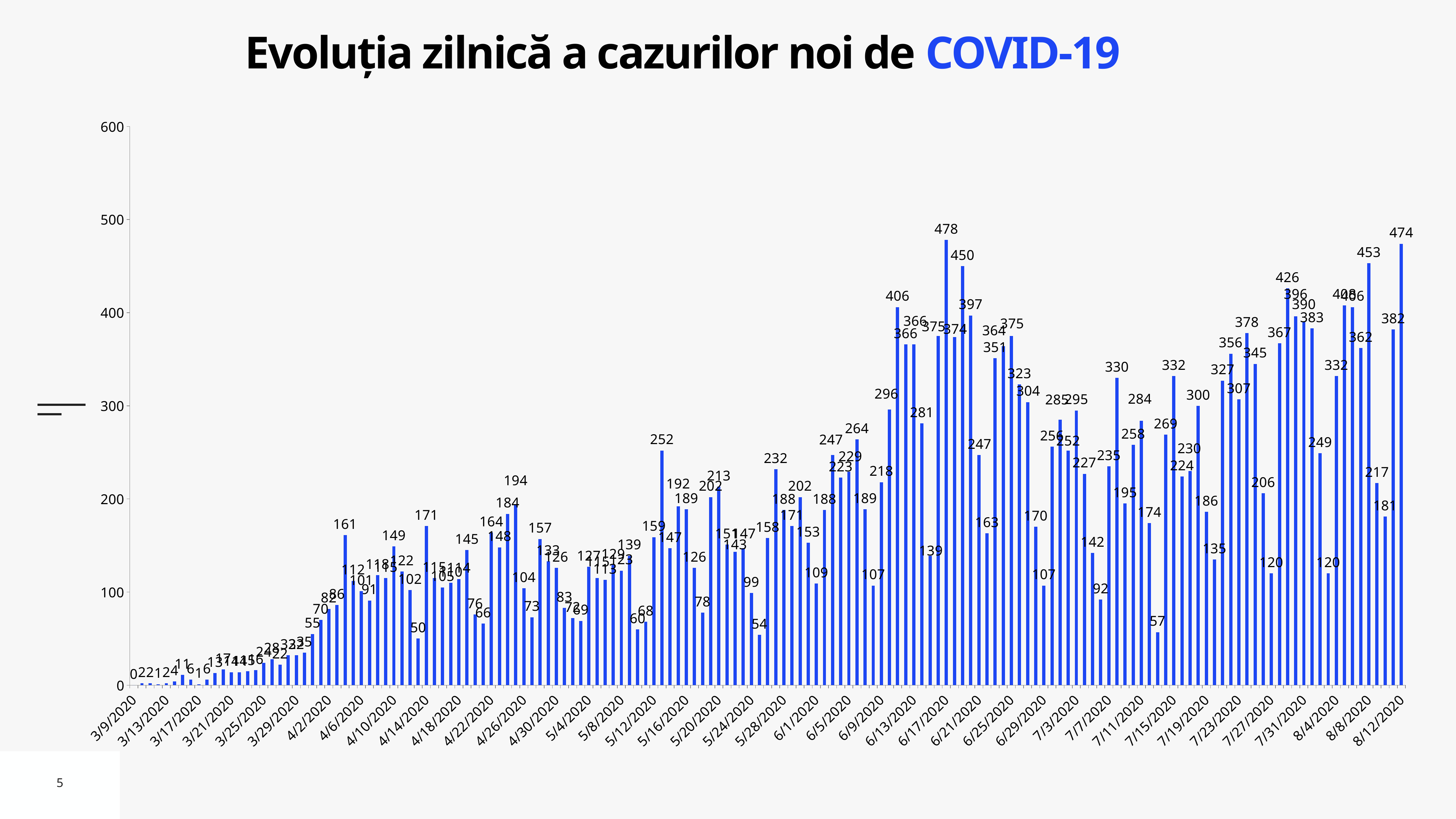
What is the value for 8/8/2020? 453 Is the value for 7/31/2020 greater or less than 300? greater What is the value for 8/12/2020? 474 What is the value for the first date, 3/9/2020? 0 What is the difference between the values for 8/12/2020 and 8/8/2020? 21 Overall, do the values rise or fall from March to August along the x axis? rise On which date does the chart reach its highest value? 6/17/2020 What kind of chart is shown on the slide? bar chart Which is larger, the value for 6/17/2020 or the value for 8/12/2020? 6/17/2020 What is the highest daily value shown on the chart? 478 What is the title of the chart? Evoluția zilnică a cazurilor noi de COVID-19 What is the value for 7/27/2020? 120